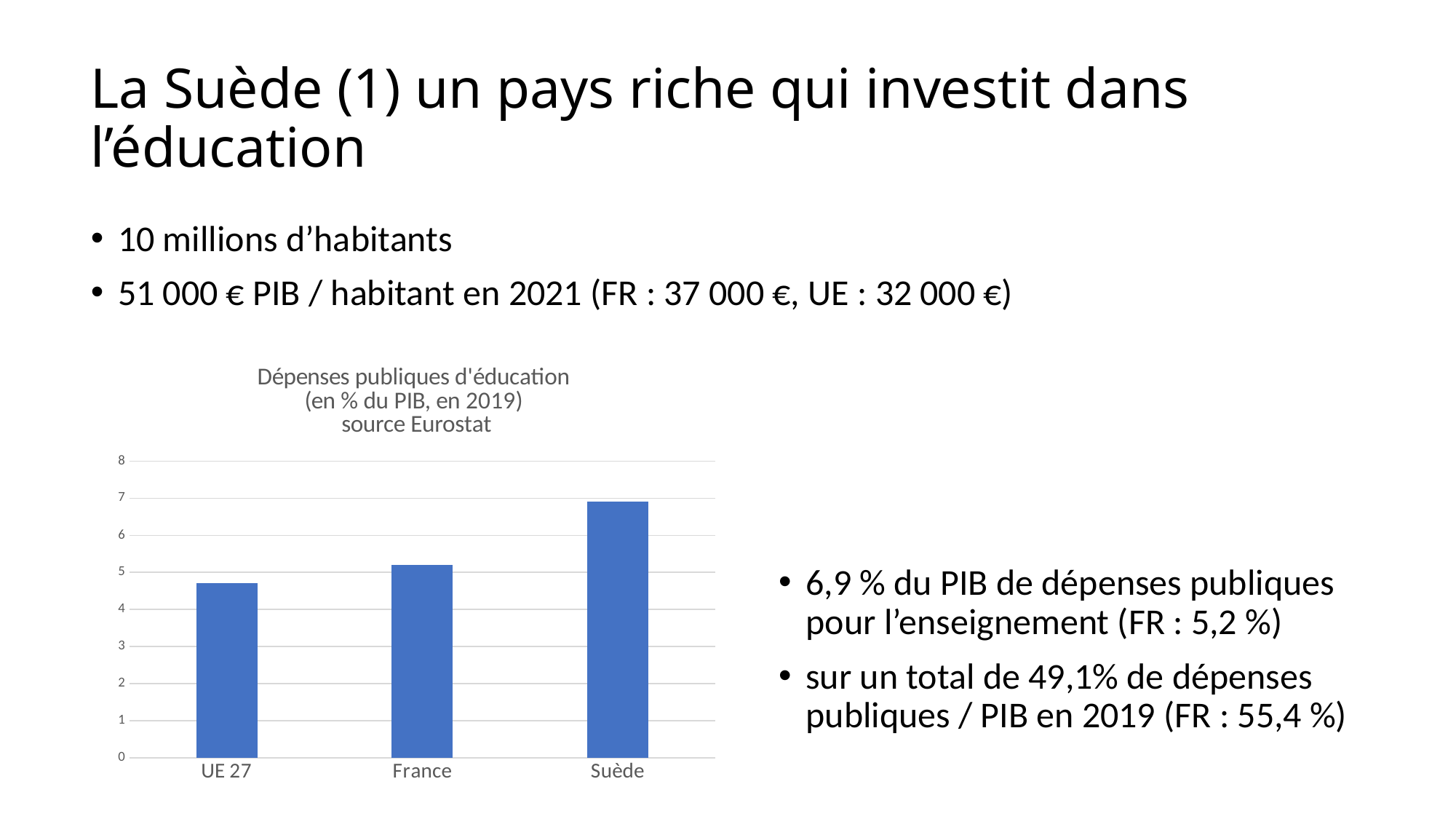
Is the value for UE 27 greater or less than 4? greater How many categories are plotted in the chart? 3 Which has the larger value, France or UE 27? France Which has the larger value, Suède or France? Suède Which category has the highest value in the chart? Suède What kind of chart is shown on the slide? bar chart Is the value for France greater or less than 5? greater Is the value for Suède greater or less than 6? greater Do the values rise or fall from left to right across the categories? rise Which category has the lowest value in the chart? UE 27 What source is cited in the chart title? Eurostat